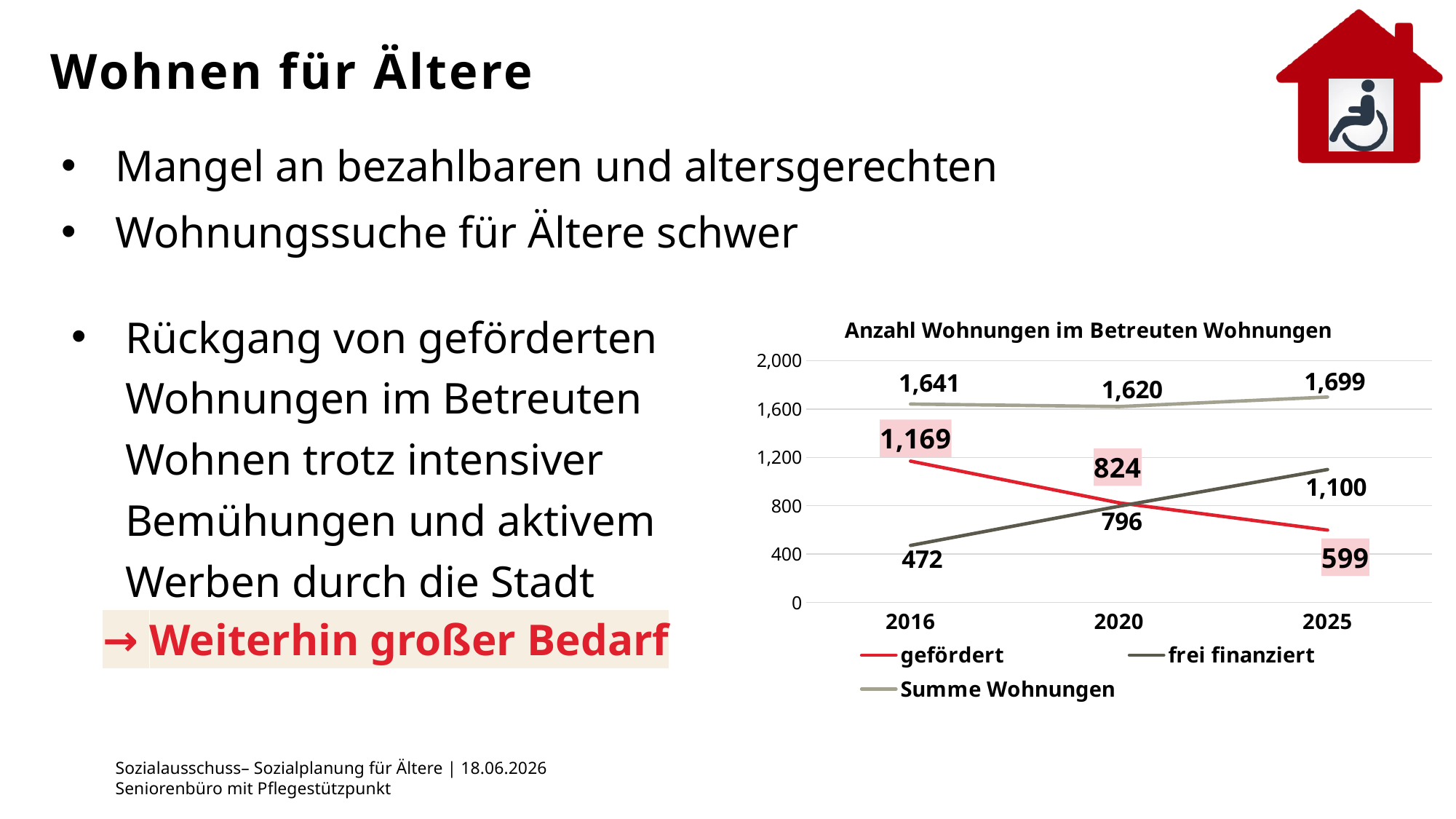
What is the value for gefördert in 2016? 1,169 What is the difference between the gefördert values in 2016 and 2025? 570 Which is larger in 2025, gefördert or frei finanziert? frei finanziert What is the value for gefördert in 2025? 599 What is the value for frei finanziert in 2025? 1,100 In which year is the Summe Wohnungen series highest? 2025 What is the value for Summe Wohnungen in 2020? 1,620 How many series does the legend list? 3 What kind of chart is shown? line chart Does the frei finanziert series rise or fall from 2016 to 2025? rise In which year is the gefördert series lowest? 2025 How many years are shown on the x axis? 3